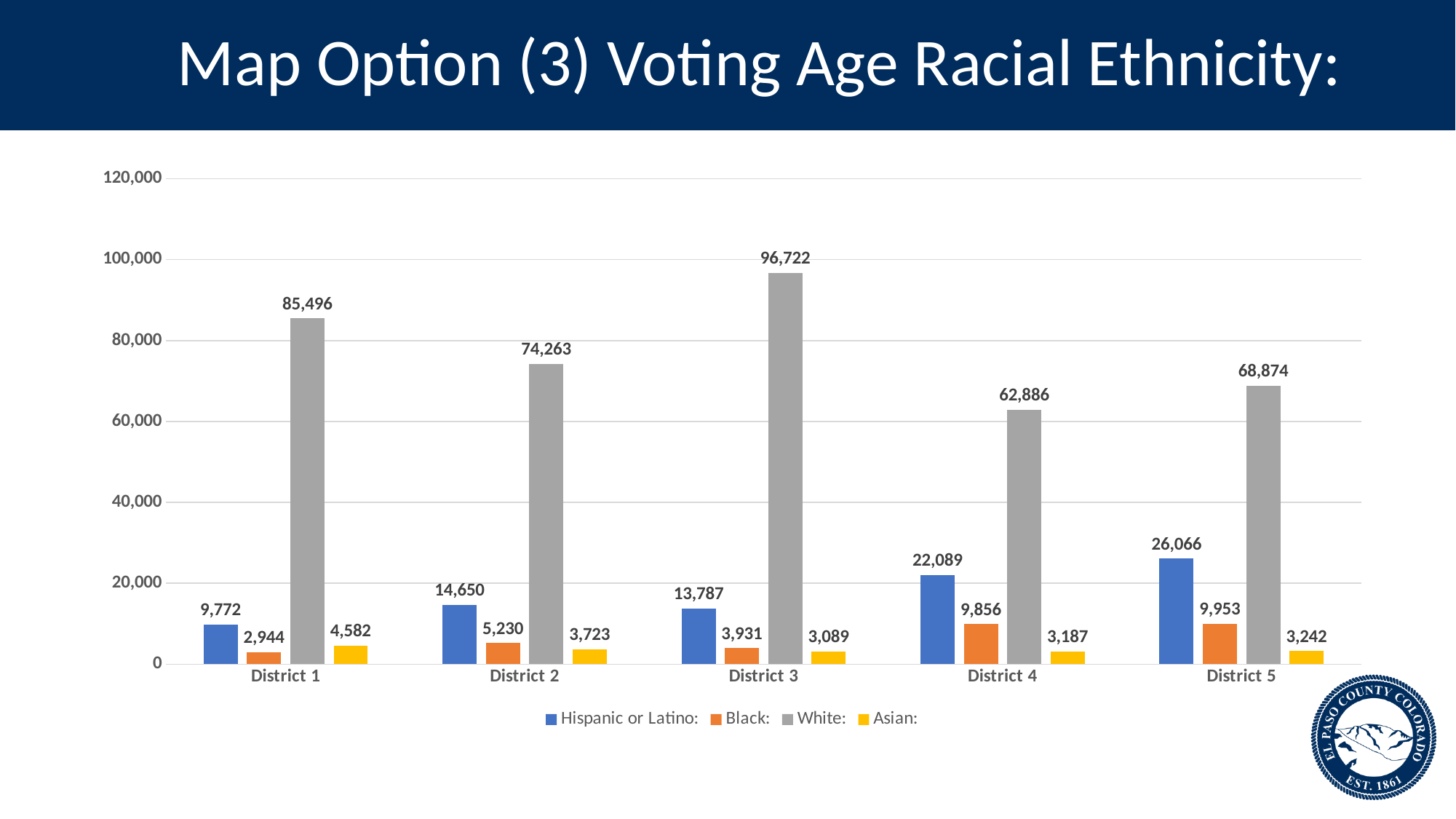
How many districts are shown on the x axis? 5 What is the difference between the Hispanic or Latino values for District 5 and District 4? 3,977 Which is larger, the Hispanic or Latino value for District 2 or for District 3? District 2 What is the Black value for District 2? 5,230 What is the Asian value for District 1? 4,582 Which district has the highest White value? District 3 Which district has the lowest Black value? District 1 How many series does the legend list? 4 What kind of chart is shown on the slide? Bar chart What is the difference between the White values for District 3 and District 1? 11,226 What is the Hispanic or Latino value for District 5? 26,066 What is the White voting-age population in District 3? 96,722